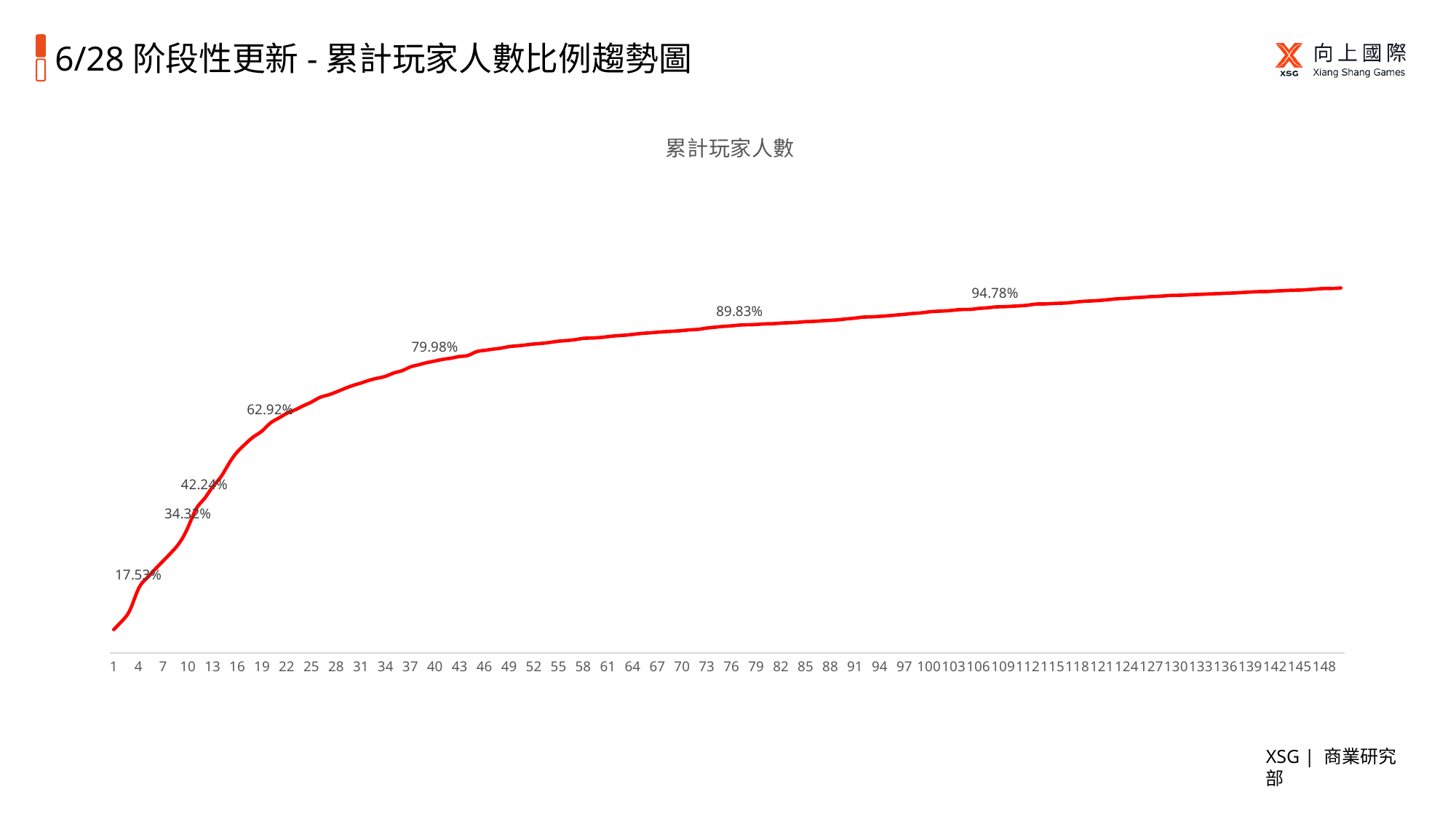
What is the highest value printed as a data label on the chart? 94.78% What is the difference between the data labels 34.32% and 17.53%? 16.79% What is the title of the chart? 累計玩家人數 What is the difference between the data labels 94.78% and 89.83%? 4.95% What is the difference between the data labels 42.24% and 34.32%? 7.92% How many data labels are printed on the line? 7 What kind of chart is shown on the slide? line chart Which is larger, the data label 62.92% or the data label 42.24%? 62.92% Do the values rise or fall along the x axis? rise What is the lowest value printed as a data label on the chart? 17.53% What colour is the line in the chart? red